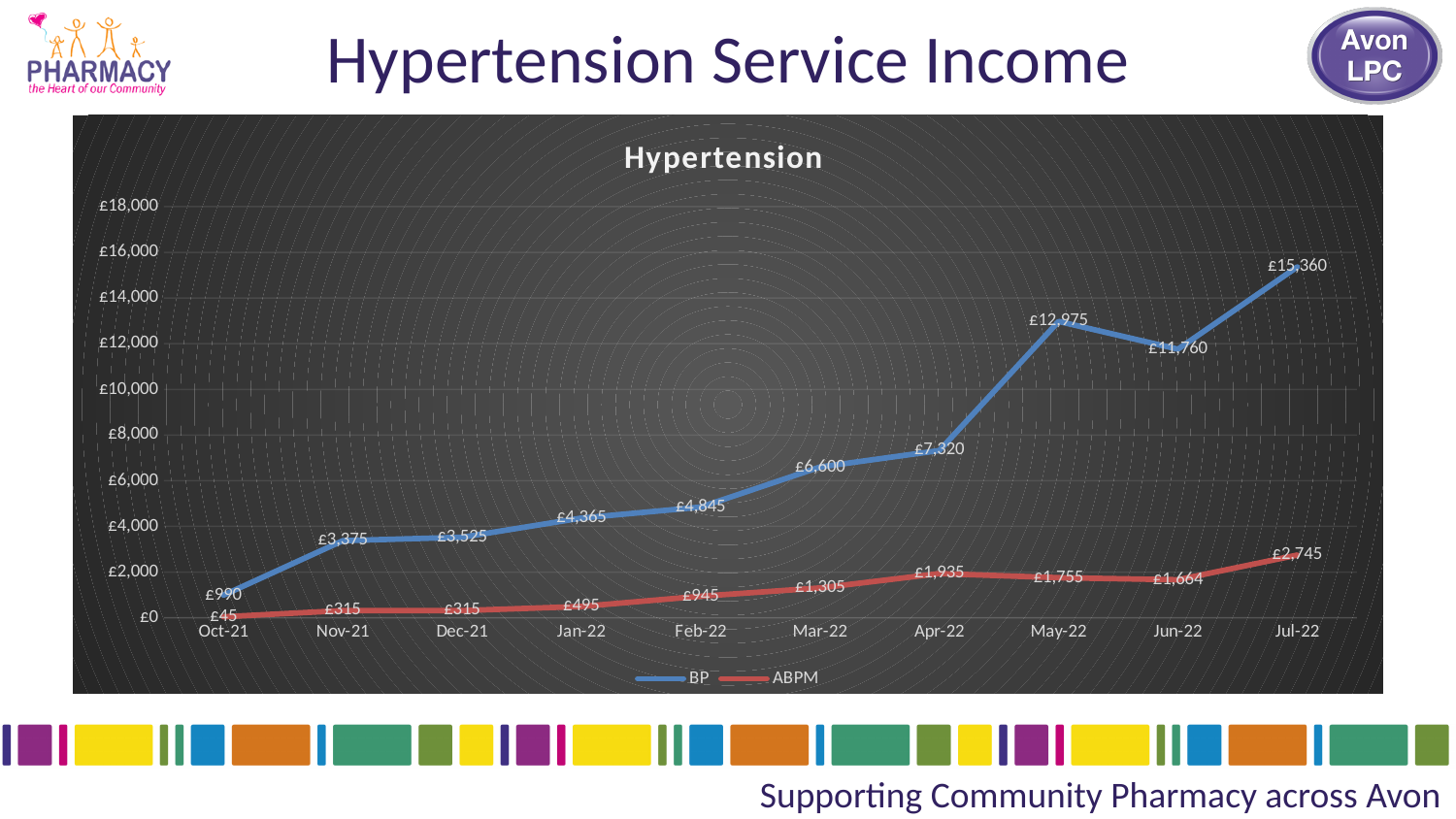
In which month is the BP value highest? Jul-22 What is the ABPM value for Apr-22? £1,935 How many series does the legend list? 2 What type of chart is shown on the slide? Line chart Is the BP value for Jul-22 greater or less than £14,000? greater Which is larger, the ABPM value for Apr-22 or for May-22? Apr-22 What is the BP value for May-22? £12,975 In which month is the ABPM value lowest? Oct-21 What is the difference between the BP values for May-22 and Jun-22? £1,215 Does the BP series generally rise or fall from Oct-21 to Jul-22? Rise How many months are plotted along the x axis? 10 What is the title of the chart? Hypertension